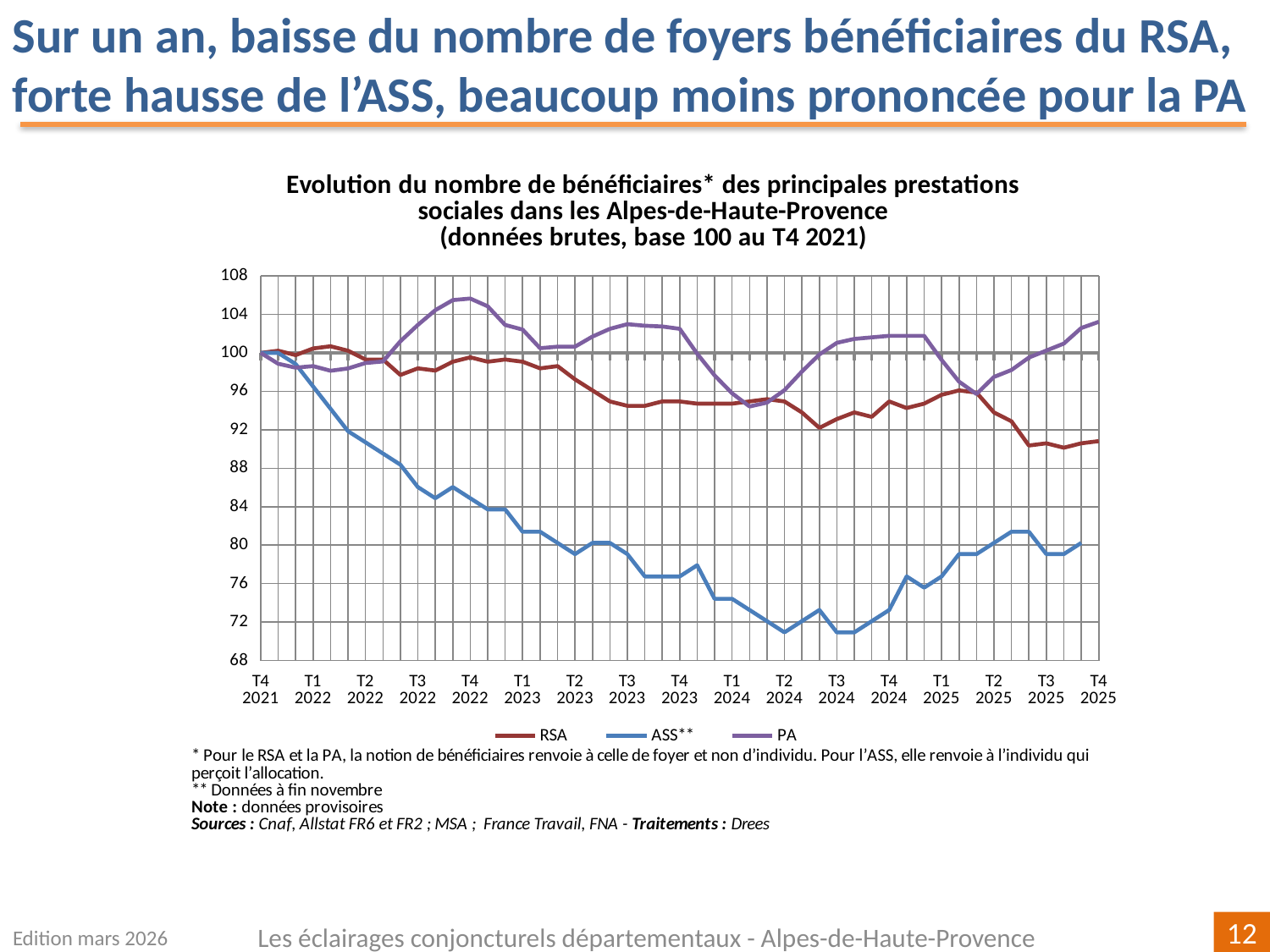
How many series does the legend list? 3 What kind of chart is shown on the slide? line chart Is the value for PA at T4 2025 greater or less than 100? greater At T2 2023, which series has the larger value, RSA or ASS**? RSA Is the value for RSA at T4 2025 greater or less than 92? less Does the ASS** series rise or fall between T4 2021 and T2 2024? fall What is the value of the RSA, ASS** and PA series at T4 2021, the base period? 100 Which series has the highest value at T4 2025? PA Which series is drawn in purple in the legend? PA How many quarter labels are shown on the x axis, from T4 2021 to T4 2025? 17